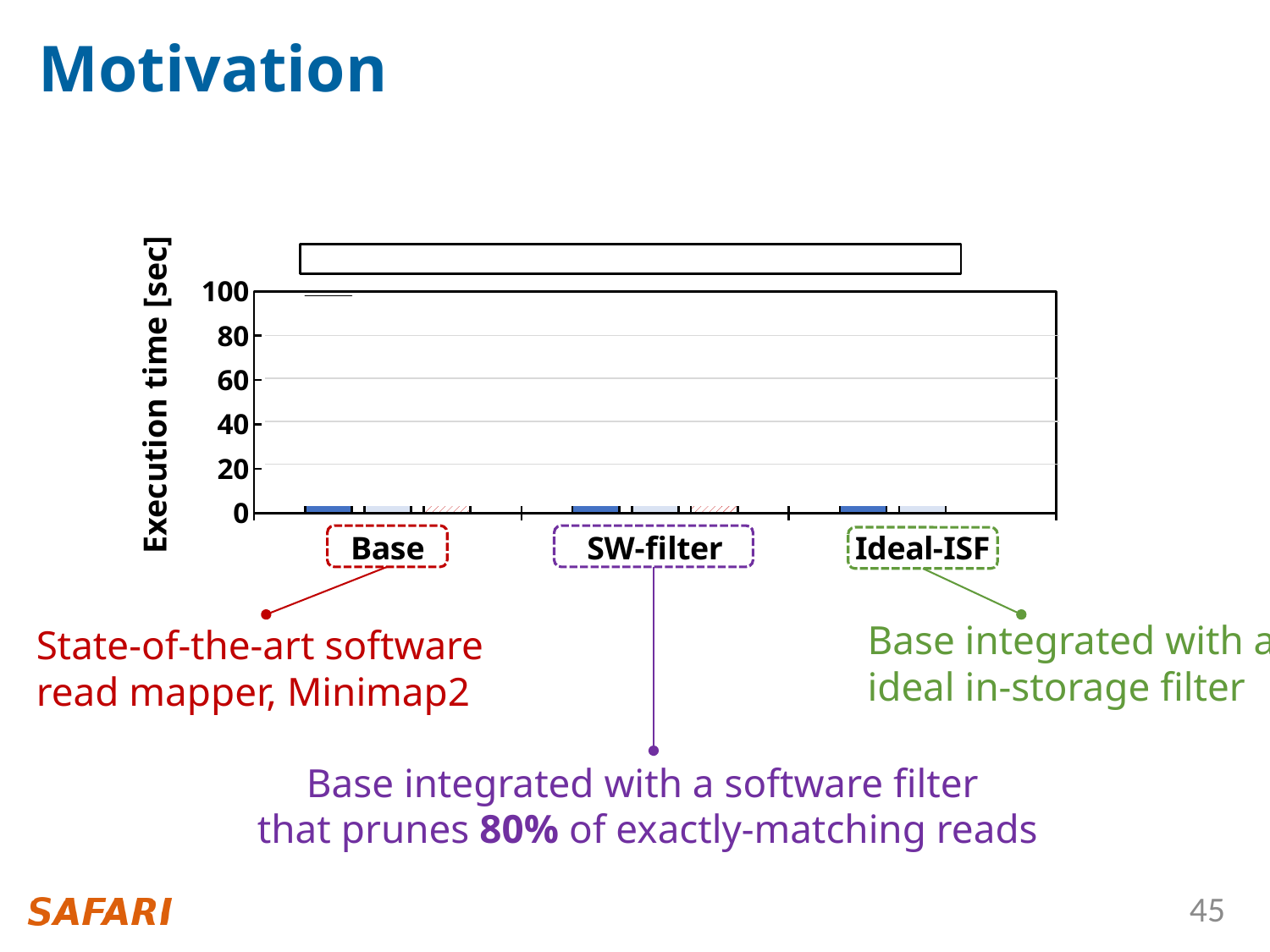
What kind of chart is shown on the slide? bar chart Which category is labelled in the middle of the x axis? SW-filter Which category is labelled furthest to the left on the x axis? Base Which category is labelled furthest to the right on the x axis? Ideal-ISF How many categories are labelled on the x axis of the chart? 3 What is the title of the y axis of the chart? Execution time [sec] What is the highest tick value shown on the y axis of the chart? 100